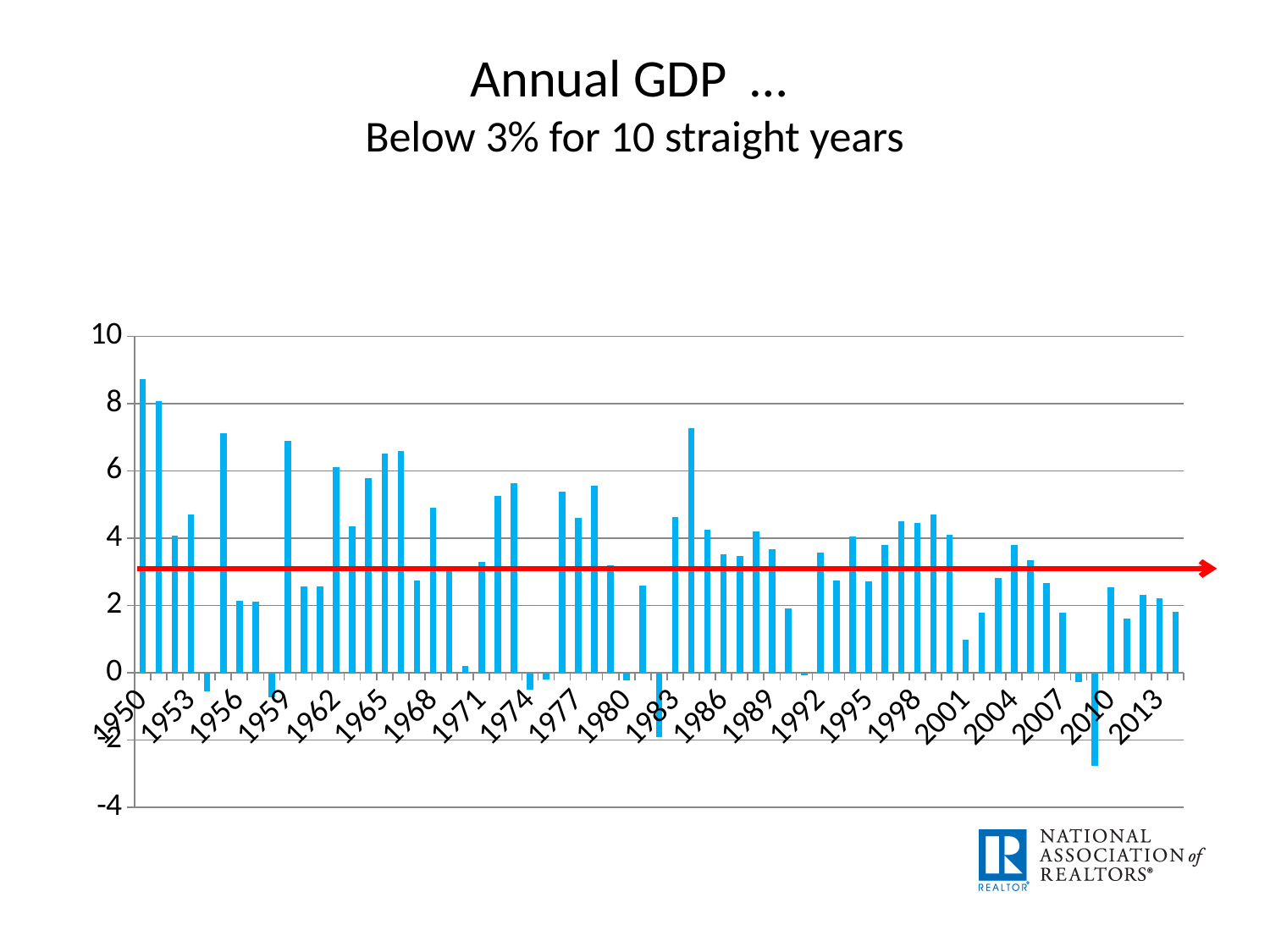
At what value on the y axis is the red horizontal line drawn? 3 Is the value for 1959 greater or less than 6? greater Is the value for 1998 greater or less than 4? greater Is the value for 1950 greater or less than 8? greater Which is larger, the value for 1950 or the value for 2013? 1950 What kind of chart is shown on the slide? bar chart Which labeled year has the highest annual GDP value? 1950 Which is larger, the value for 1959 or the value for 1956? 1959 Do the annual GDP values generally rise or fall from 1950 to 2013? fall